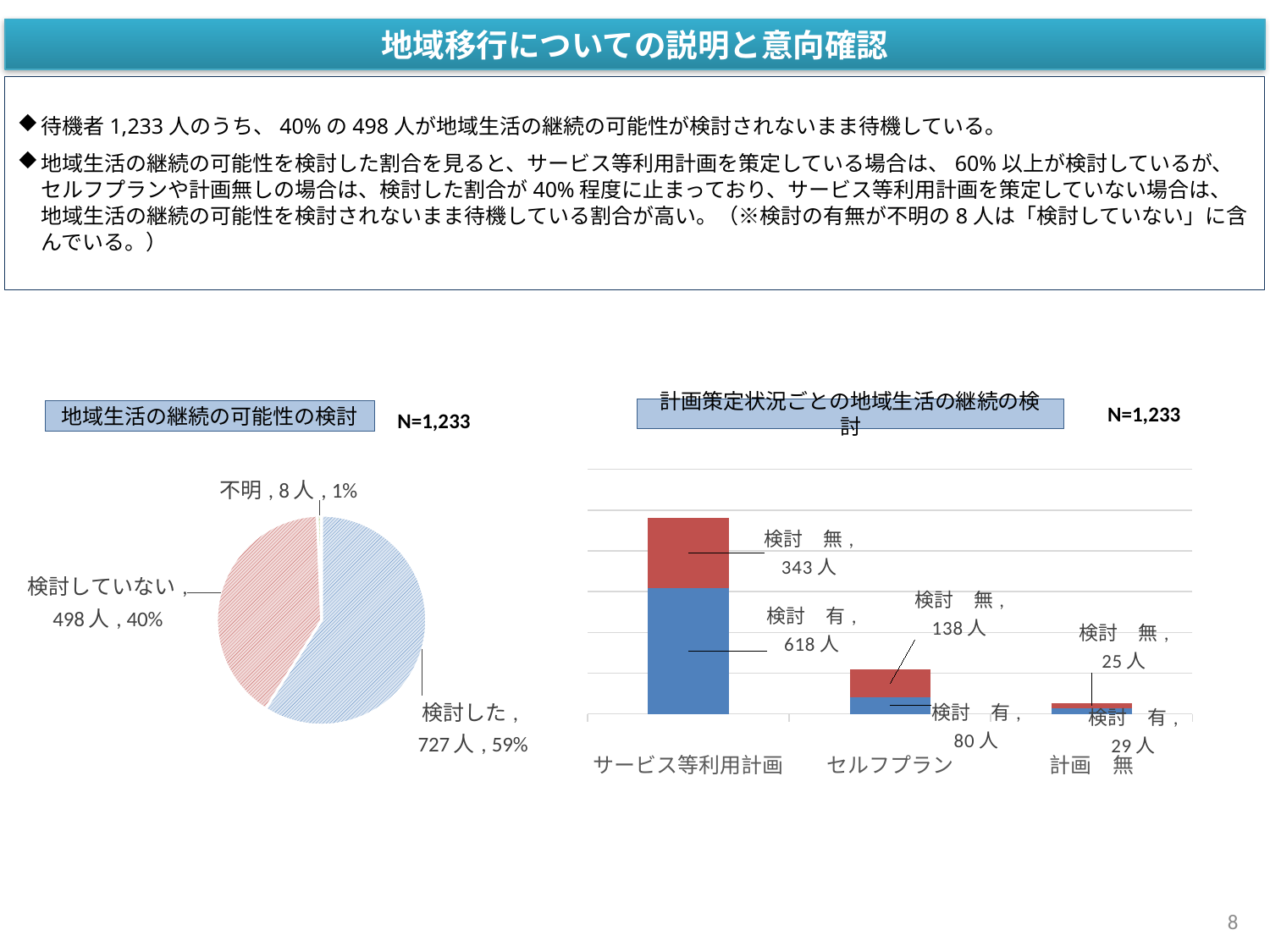
In the pie chart titled 地域生活の継続の可能性の検討, what is the difference in people between 検討した and 検討していない? 229人 In the pie chart titled 地域生活の継続の可能性の検討, which slice is the smallest? 不明 In the pie chart titled 地域生活の継続の可能性の検討, what share of the pie is 検討していない? 40% In the bar chart titled 計画策定状況ごとの地域生活の継続の検討, what is the total of the stacked bar for 計画 無? 54人 In the bar chart titled 計画策定状況ごとの地域生活の継続の検討, for セルフプラン, which is larger: 検討 有 or 検討 無? 検討 無 In the bar chart titled 計画策定状況ごとの地域生活の継続の検討, how many people are 検討 有 for サービス等利用計画? 618人 What kind of chart is the chart on the right of the slide? Stacked bar chart In the pie chart titled 地域生活の継続の可能性の検討, how many slices does the pie have? 3 In the pie chart titled 地域生活の継続の可能性の検討, how many people are in the 検討した slice? 727人 In the bar chart titled 計画策定状況ごとの地域生活の継続の検討, which category has the tallest stacked bar? サービス等利用計画 In the bar chart titled 計画策定状況ごとの地域生活の継続の検討, how many people are 検討 無 for セルフプラン? 138人 What kind of chart is the chart on the left of the slide? Pie chart